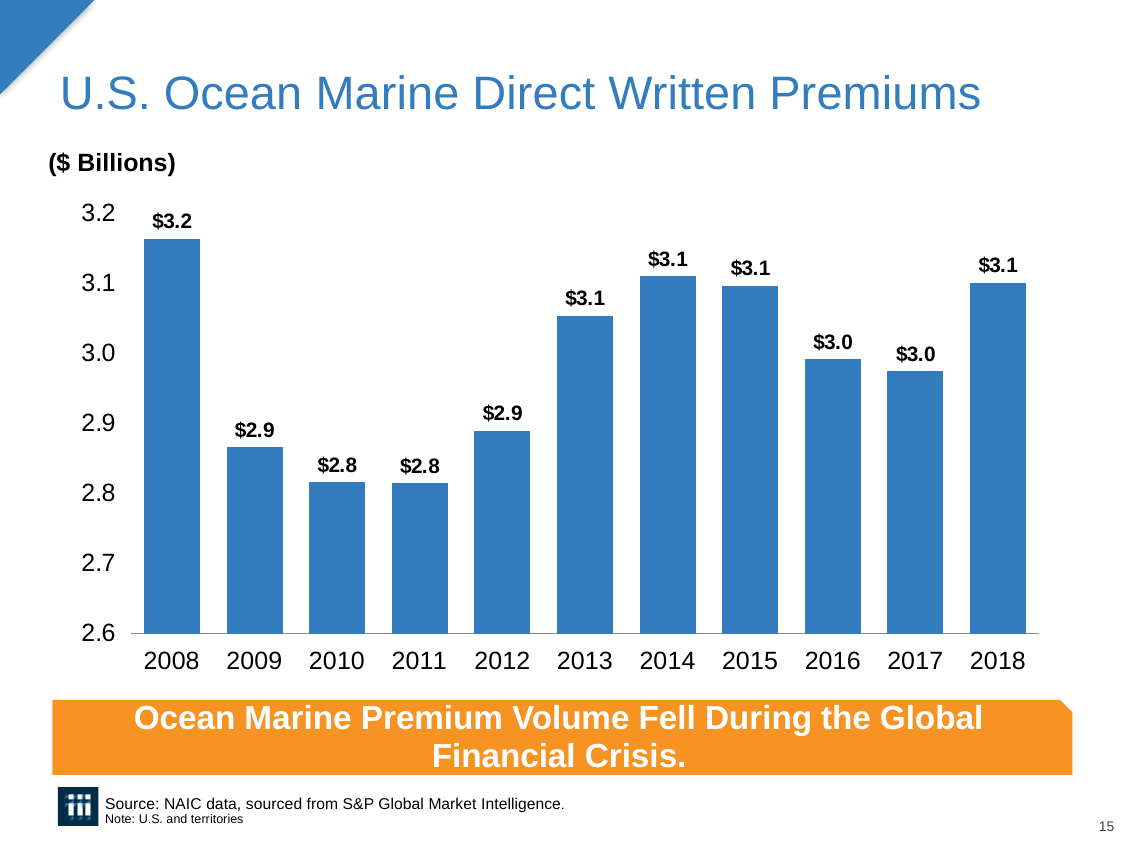
Do the values rise or fall from 2008 to 2011? fall What is the difference between the values for 2008 and 2010? $0.4 Is the value for 2014 greater or less than 3.0? greater Which is larger, the value for 2013 or the value for 2012? 2013 What is the value for 2018? $3.1 What type of chart is shown on the slide? Bar chart What is the value for 2012? $2.9 What unit is stated above the chart? $ Billions Which year has the highest value? 2008 How many years are shown on the x axis? 11 What is the value for 2016? $3.0 What is the value for 2008? $3.2